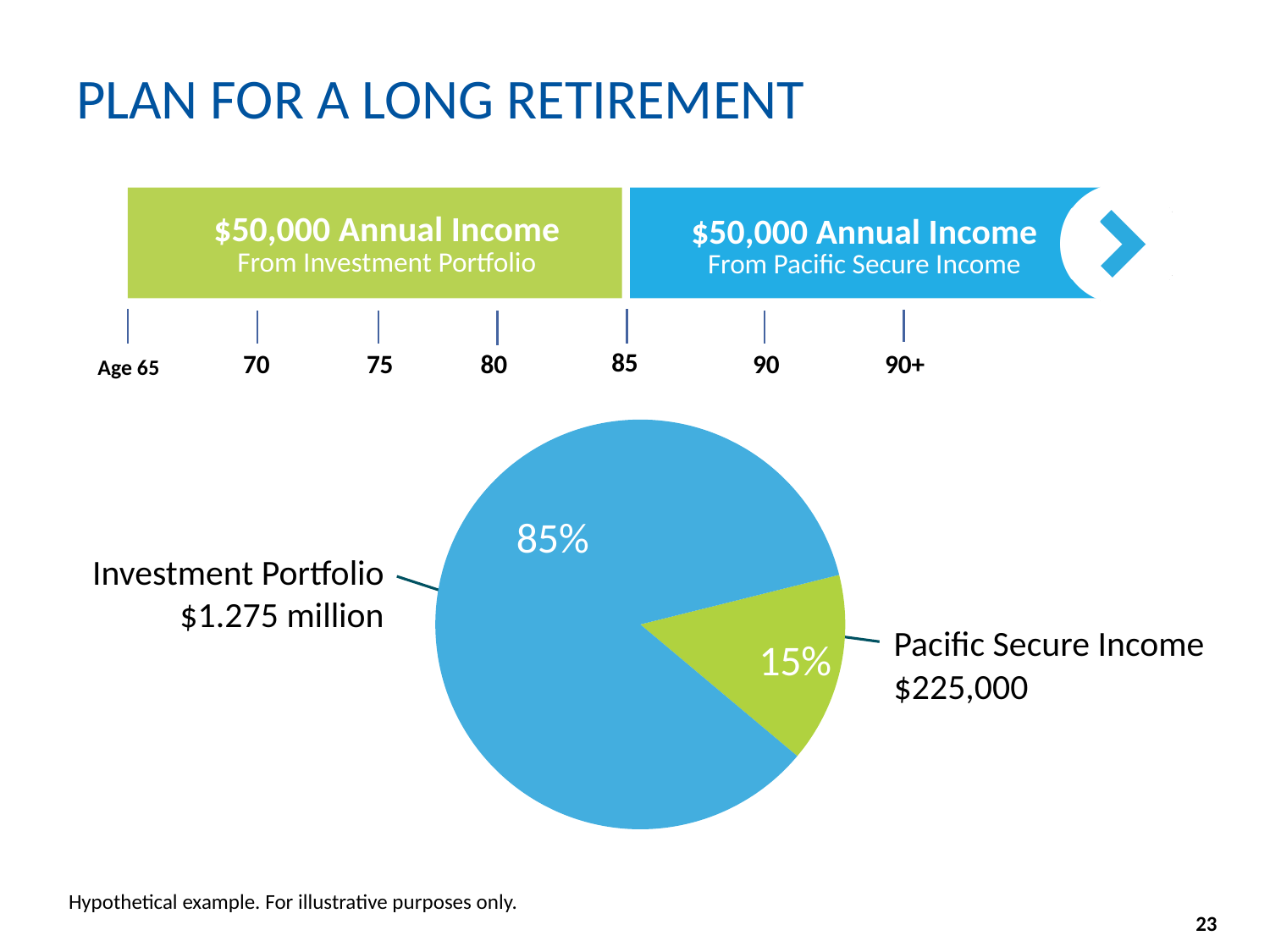
Which slice of the pie chart is the largest? Investment Portfolio What dollar amount is shown for the Pacific Secure Income slice? $225,000 What share of the pie does Investment Portfolio represent? 85% Which is larger, the Investment Portfolio slice or the Pacific Secure Income slice? Investment Portfolio What kind of chart is shown on the slide? pie chart What dollar amount is shown for the Investment Portfolio slice? $1.275 million Which slice of the pie chart is the smallest? Pacific Secure Income What colour is the Pacific Secure Income slice of the pie chart? green What is the difference in percentage points between the Investment Portfolio share and the Pacific Secure Income share? 70 percentage points What colour is the Investment Portfolio slice of the pie chart? blue How many slices does the pie chart have? 2 What share of the pie does Pacific Secure Income represent? 15%